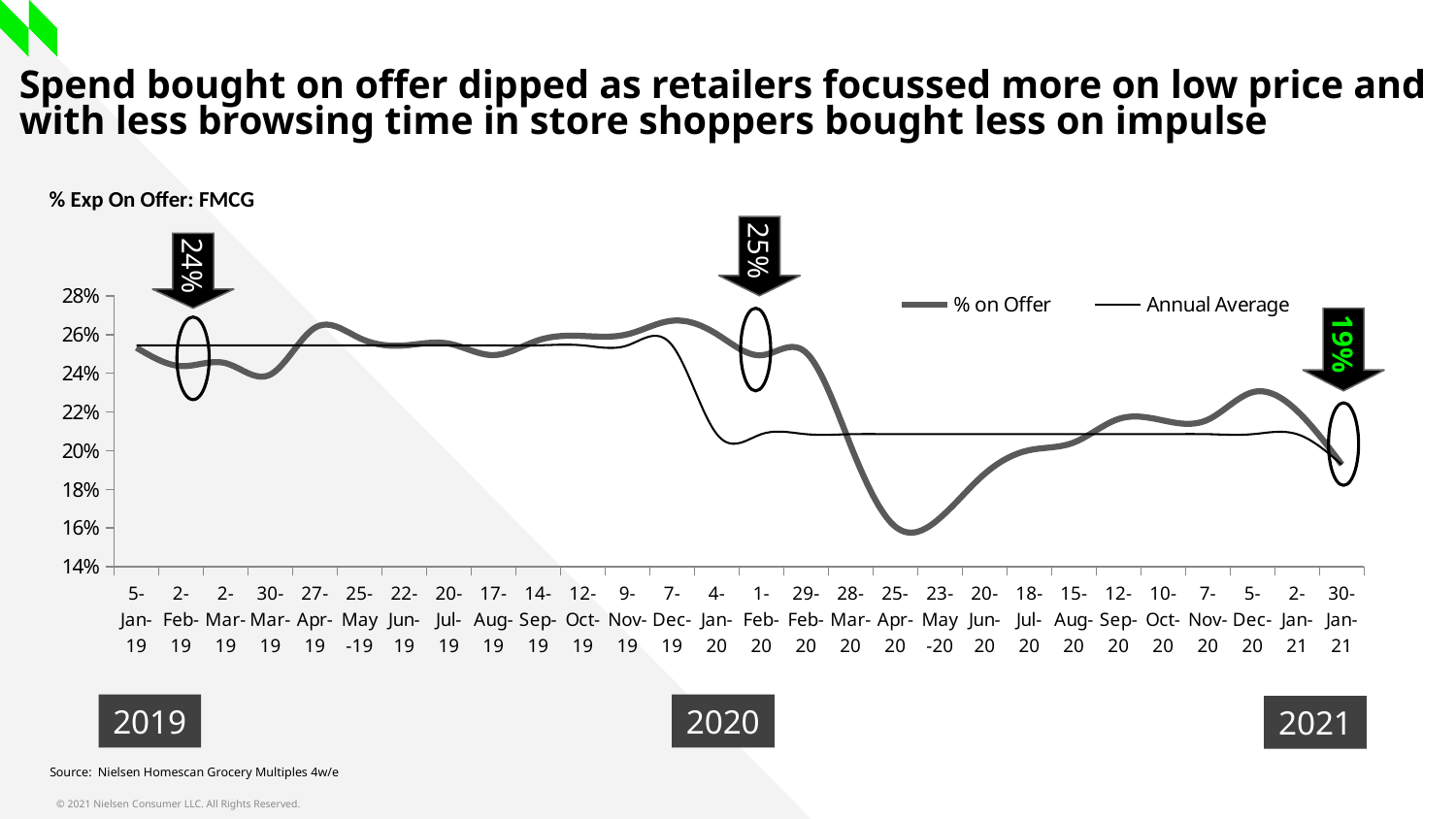
What % on Offer value is called out for the circled point at 30-Jan-21? 19% At which date does the % on Offer line reach its lowest point? 25-Apr-20 What is the title of the chart? % Exp On Offer: FMCG How many dated points are shown along the x axis of the chart? 28 What % on Offer value is called out for the circled point at 1-Feb-20? 25% Does the % on Offer line rise or fall between 7-Dec-19 and 25-Apr-20? fall What are the two series named in the chart legend? % on Offer and Annual Average What % on Offer value is called out for the circled point at 2-Feb-19? 24% How many series does the chart legend list? 2 What kind of chart is shown on the slide? line chart By how many percentage points does the called-out value at 1-Feb-20 (25%) exceed the called-out value at 30-Jan-21 (19%)? 6 percentage points Is the % on Offer value at 25-Apr-20 greater or less than 18%? less